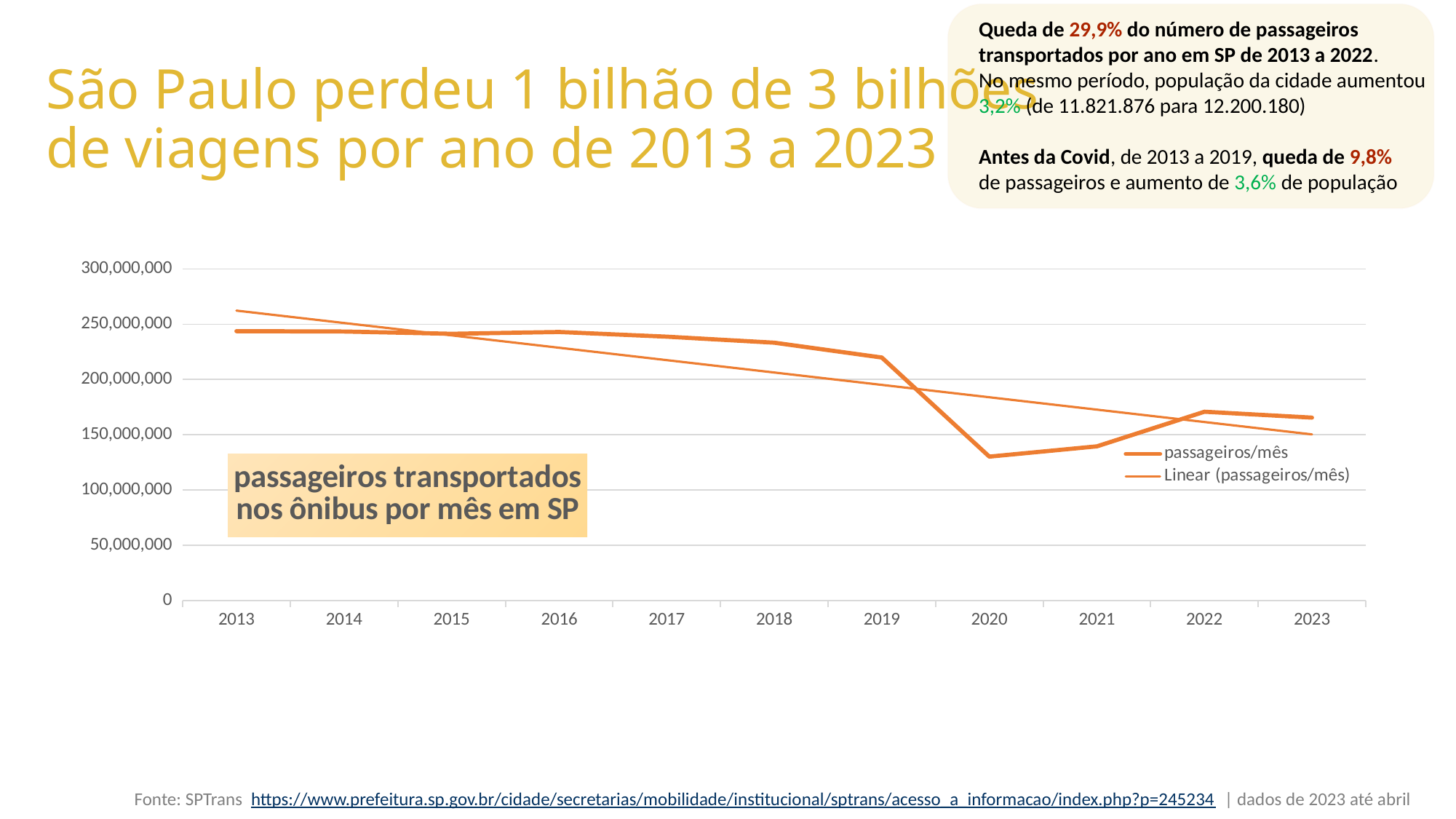
Is the value for passageiros/mês in 2013 greater or less than 250,000,000? less Is the value for passageiros/mês in 2019 greater or less than 200,000,000? greater What are the two entries listed in the chart legend? passageiros/mês and Linear (passageiros/mês) How many years are plotted along the x axis of the chart? 11 Is the value for passageiros/mês in 2020 greater or less than 150,000,000? less Which is larger, the passageiros/mês value for 2019 or for 2020? 2019 Which is larger, the passageiros/mês value for 2021 or for 2022? 2022 What kind of chart is shown on the slide? line chart Overall, do the passageiros/mês values rise or fall from 2013 to 2023? fall Which year has the lowest value for passageiros/mês? 2020 How many series does the chart legend list? 2